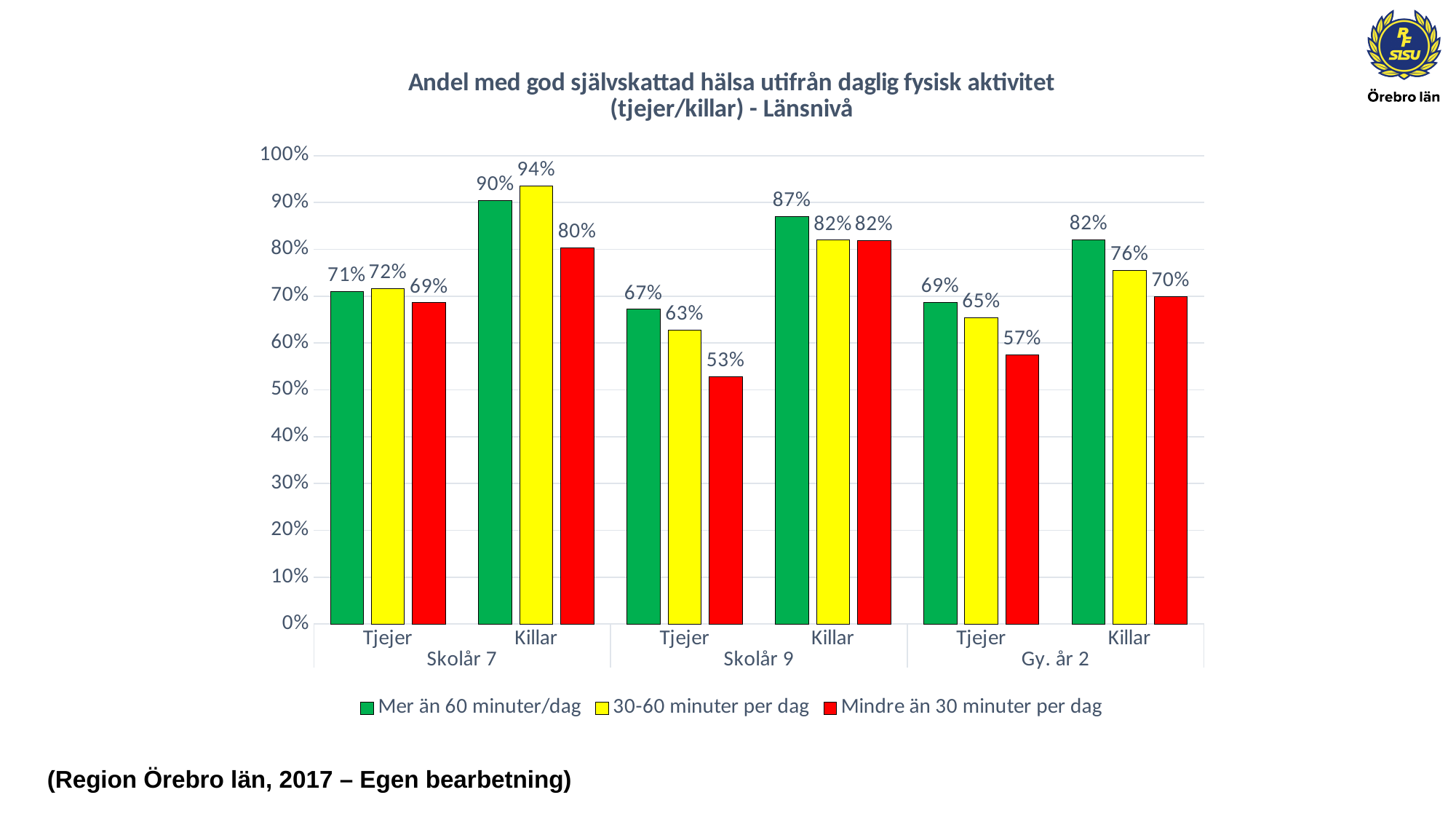
Is the value for Killar in Skolår 7 for 'Mindre än 30 minuter per dag' greater or less than 70%? greater What kind of chart is shown on the slide? Bar chart How many groups of bars (Tjejer/Killar categories) are shown on the x axis? 6 What is the value for Killar in Skolår 7 for the series 'Mer än 60 minuter/dag'? 90% What is the value for Tjejer in Skolår 9 for the series 'Mindre än 30 minuter per dag'? 53% Which is larger for Tjejer in Gy. år 2: 'Mer än 60 minuter/dag' or 'Mindre än 30 minuter per dag'? Mer än 60 minuter/dag What is the difference between the 'Mer än 60 minuter/dag' value for Killar and for Tjejer in Skolår 9? 20 percentage points How many series does the legend list? 3 What is the value for Killar in Gy. år 2 for the series '30-60 minuter per dag'? 76% Which group and series has the lowest value in the chart? Tjejer, Skolår 9, Mindre än 30 minuter per dag (53%) What colour represents the series 'Mindre än 30 minuter per dag'? Red Which group and series has the highest value in the chart? Killar, Skolår 7, 30-60 minuter per dag (94%)